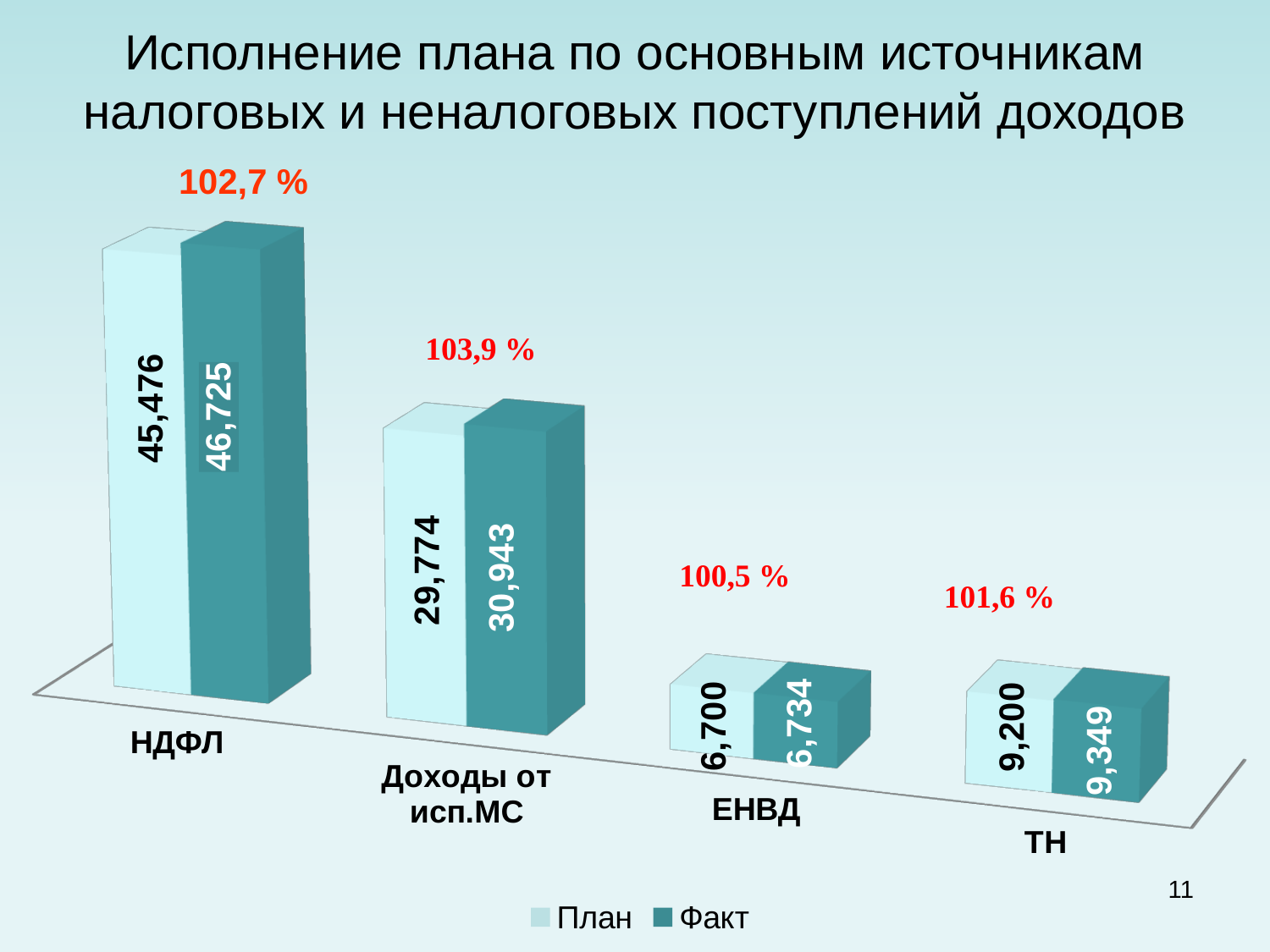
What percentage is shown above the bars for Доходы от исп.МС? 103,9 % Which category has the lowest План value? ЕНВД What is the Факт value for ТН? 9,349 What is the Факт value for Доходы от исп.МС? 30,943 How many categories are shown on the x axis? 4 What is the План value for НДФЛ? 45,476 What is the difference between the Факт and План values for НДФЛ? 1,249 What is the difference between the Факт and План values for ТН? 149 Which category has the highest Факт value? НДФЛ What is the План value for ЕНВД? 6,700 Which is larger, the План value for ТН or the Факт value for ЕНВД? План value for ТН How many series does the legend list? 2